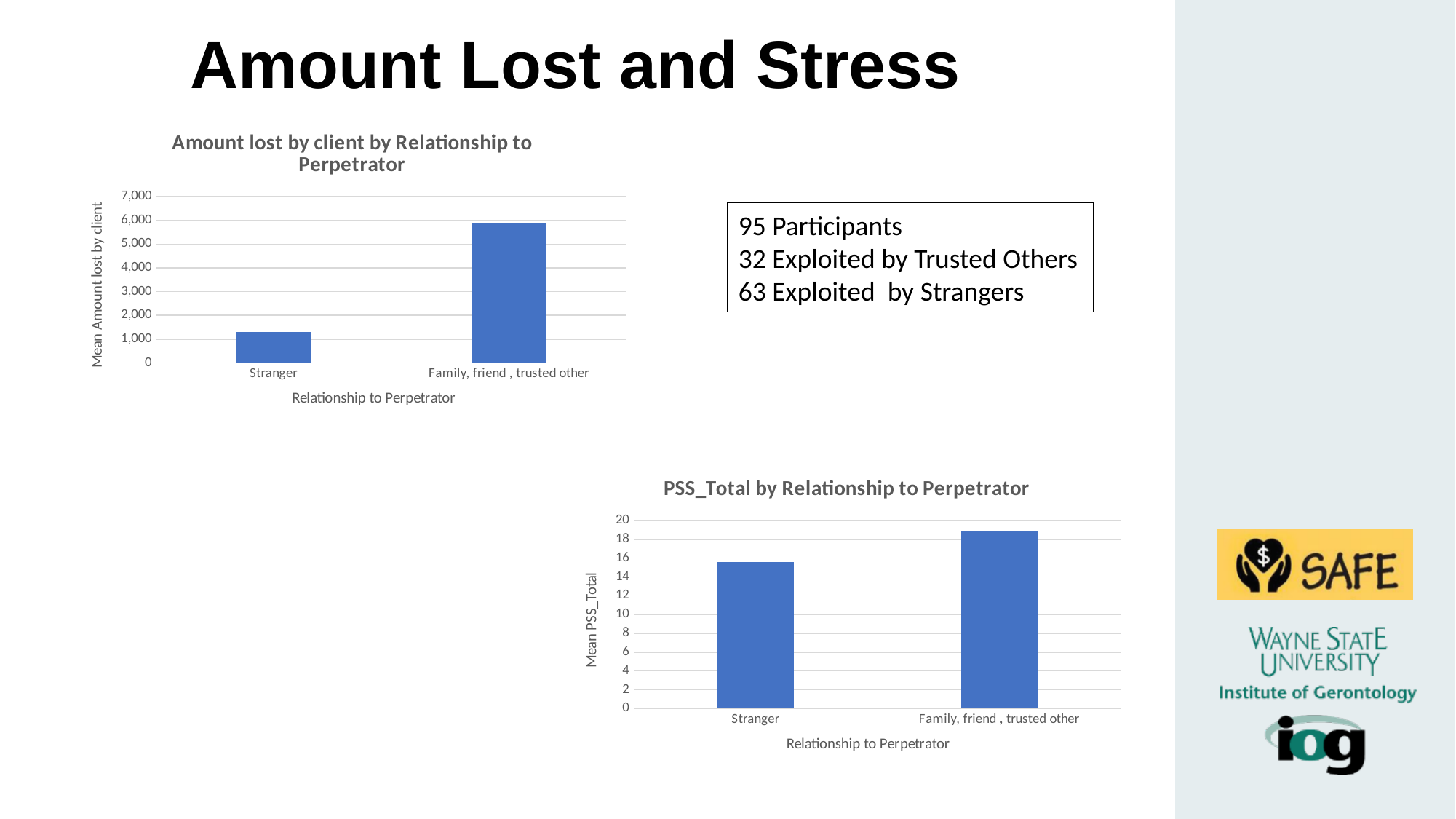
What is the y-axis label of the 'PSS_Total by Relationship to Perpetrator' chart? Mean PSS_Total What kind of chart is 'Amount lost by client by Relationship to Perpetrator'? bar chart In the 'Amount lost by client by Relationship to Perpetrator' chart, which category has the lowest mean amount lost? Stranger In the 'Amount lost by client by Relationship to Perpetrator' chart, how many categories are shown on the x axis? 2 What is the x-axis label of the 'Amount lost by client by Relationship to Perpetrator' chart? Relationship to Perpetrator In the 'PSS_Total by Relationship to Perpetrator' chart, is the value for Family, friend, trusted other greater or less than 20? less In the 'PSS_Total by Relationship to Perpetrator' chart, is the value for Stranger greater or less than 14? greater In the 'Amount lost by client by Relationship to Perpetrator' chart, is the value for Family, friend, trusted other greater or less than 5,000? greater In the 'Amount lost by client by Relationship to Perpetrator' chart, which category has the highest mean amount lost? Family, friend , trusted other In the 'PSS_Total by Relationship to Perpetrator' chart, which category has the higher mean PSS_Total? Family, friend , trusted other In the 'PSS_Total by Relationship to Perpetrator' chart, which is larger: the value for Stranger or the value for Family, friend, trusted other? Family, friend , trusted other